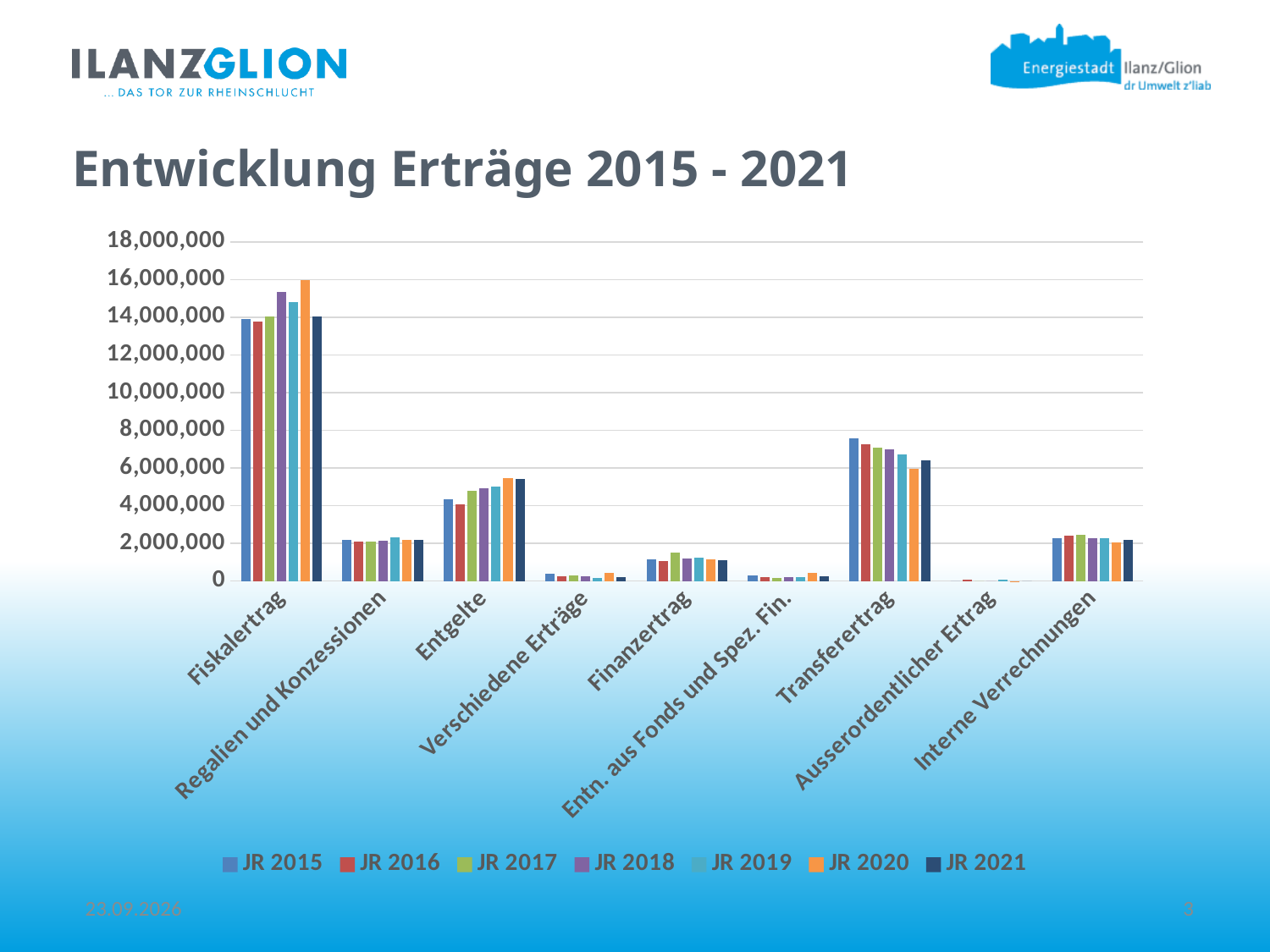
Which category has the highest values in the chart? Fiskalertrag Which is larger for Fiskalertrag: the value for JR 2020 or JR 2021? JR 2020 Is the value for Fiskalertrag in JR 2020 greater or less than 14,000,000? greater Which is larger for Transferertrag: the value for JR 2015 or JR 2021? JR 2015 What kind of chart is shown on the slide? Bar chart Is the value for Transferertrag in JR 2015 greater or less than 6,000,000? greater How many series does the legend list? 7 Is the value for Finanzertrag in JR 2017 greater or less than 2,000,000? less What is the title of the chart on the slide? Entwicklung Erträge 2015 - 2021 Which category has the lowest values in the chart? Ausserordentlicher Ertrag How many categories are shown on the x axis of the chart? 9 Do the values for Transferertrag rise or fall from JR 2015 to JR 2020? fall